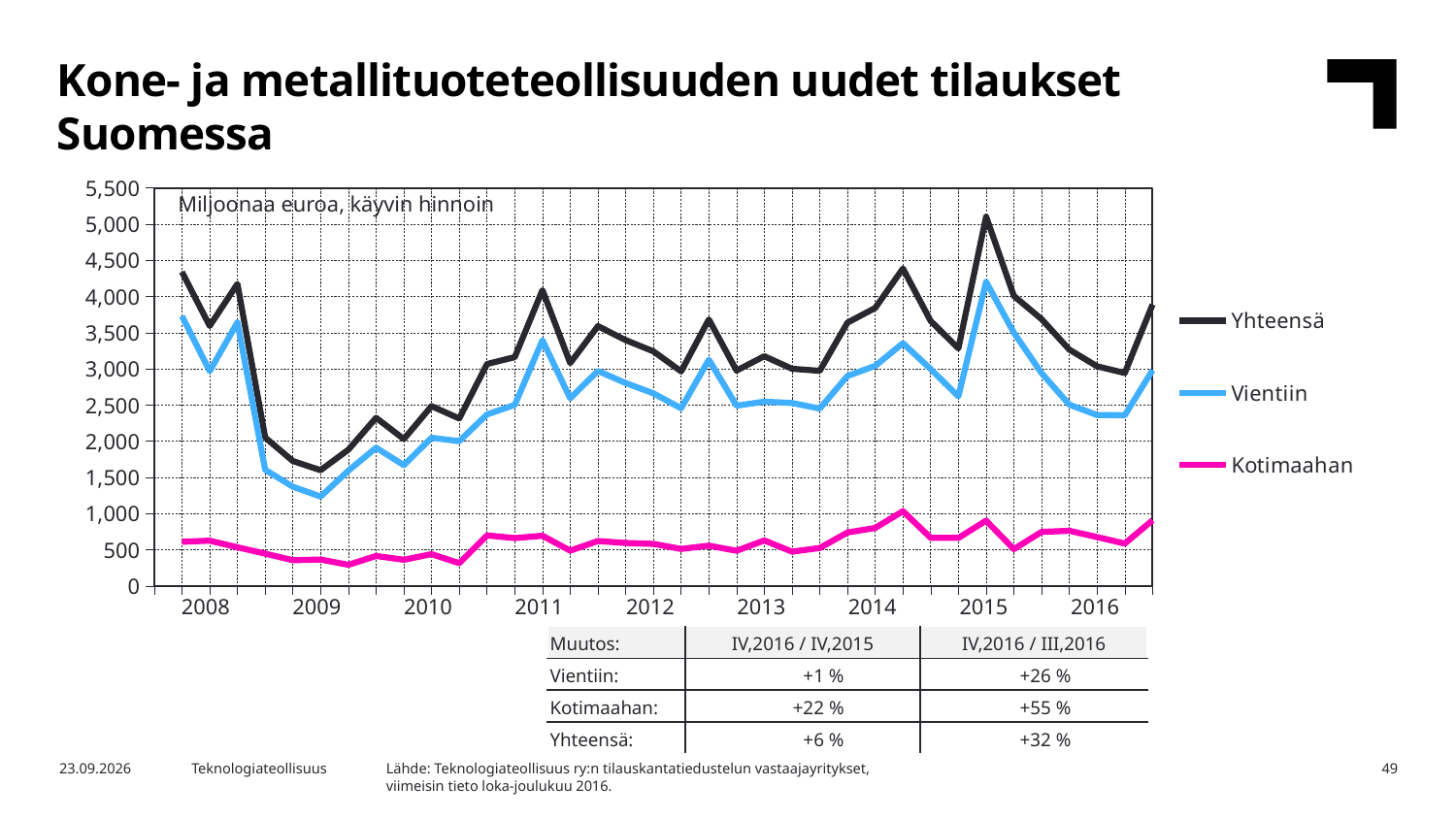
Is the highest value of Kotimaahan greater or less than 1,500? less In which year does the Yhteensä series reach its highest value? 2015 What kind of chart is shown on the slide? line chart How many series does the legend list? 3 Is the lowest value of Vientiin in 2009 greater or less than 1,500? less What unit label is printed inside the plot area? Miljoonaa euroa, käyvin hinnoin Which series has the lowest values across the whole chart? Kotimaahan Is the peak value of Yhteensä in 2015 greater or less than 4,500? greater At the 2015 peak, which series is higher, Yhteensä or Vientiin? Yhteensä What are the three series named in the legend? Yhteensä, Vientiin, Kotimaahan Does the Yhteensä series rise or fall from the start of 2008 to 2009? fall Does the Vientiin series rise or fall from 2009 to 2011? rise